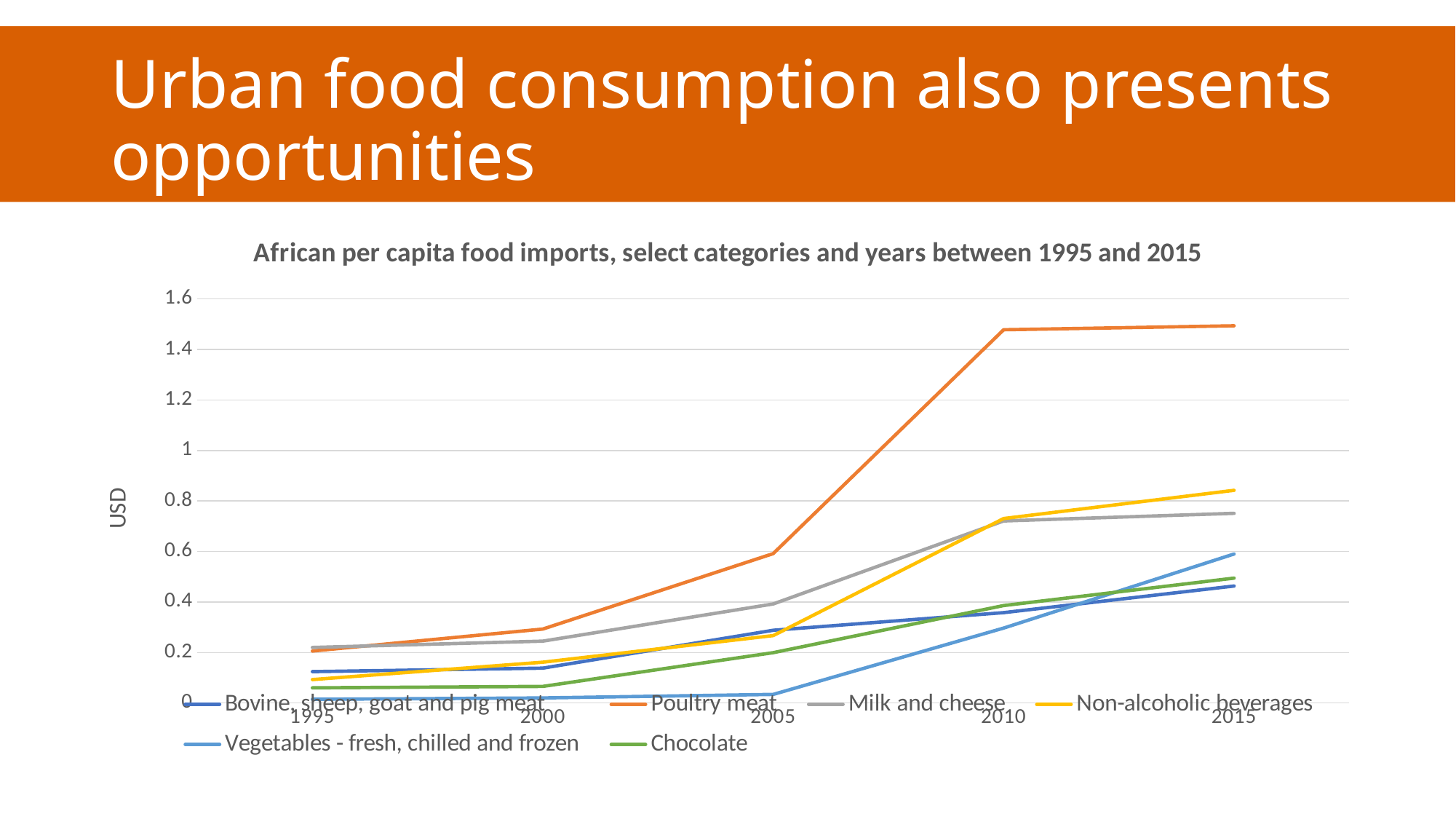
Which series has the highest value in 2015? Poultry meat Is the value for Chocolate in 1995 greater or less than 0.2? less Is the value for Milk and cheese in 2010 greater or less than 0.6? greater How many years are plotted along the x axis? 5 Is the value for Poultry meat in 2015 greater or less than 1.4? greater Which series has the lowest value in 2005? Vegetables - fresh, chilled and frozen How many series does the legend list? 6 Does the Poultry meat line rise or fall from 1995 to 2015? rise What kind of chart is shown on the slide? line chart In 2015, which is larger: Non-alcoholic beverages or Milk and cheese? Non-alcoholic beverages What is the label on the y axis? USD